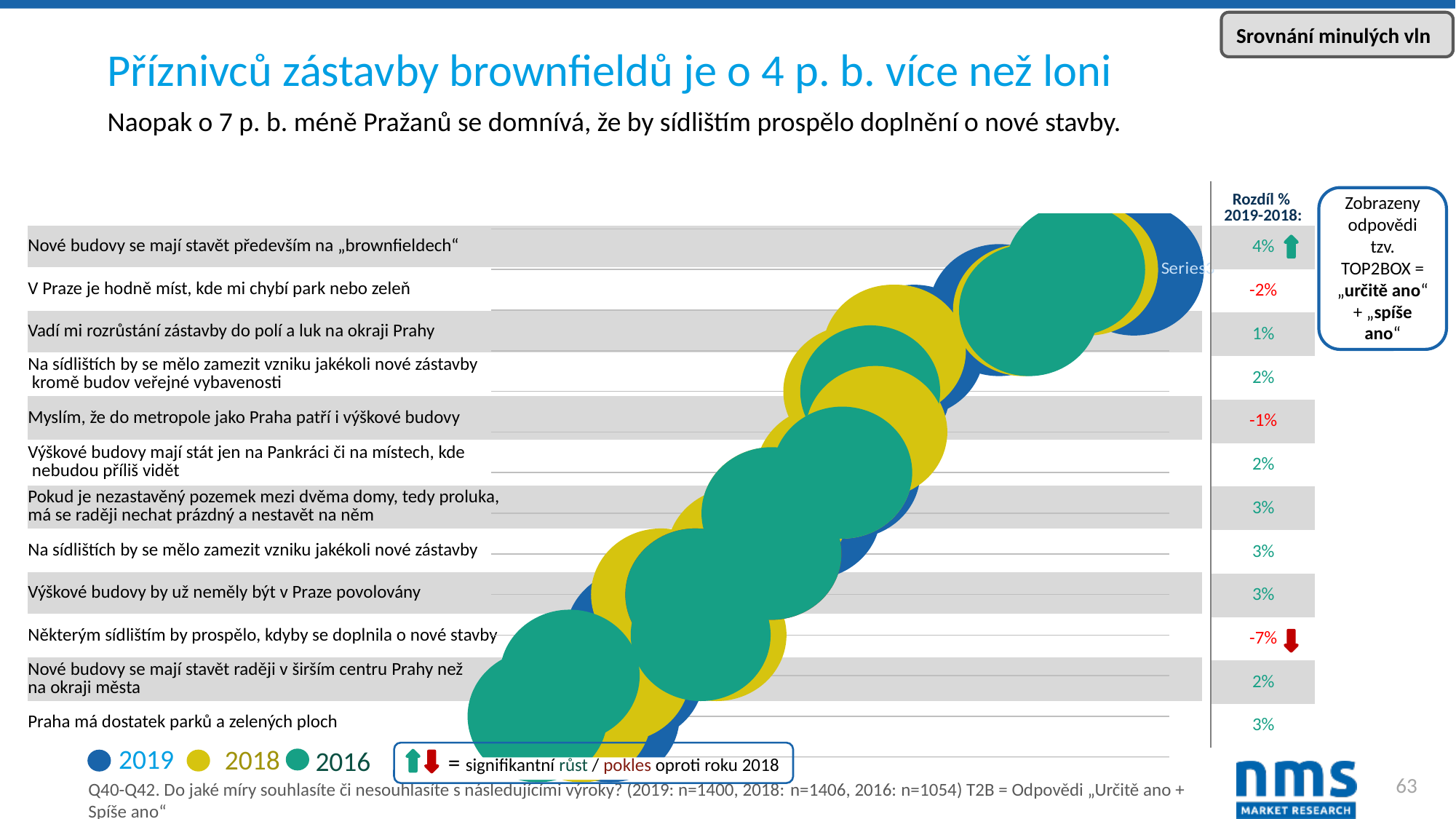
How many series does the legend list? 3 What is the 2019-2018 difference (Rozdíl %) shown for "Nové budovy se mají stavět především na „brownfieldech“"? 4% Which statement has the lowest (most negative) 2019-2018 difference in the Rozdíl % column? Některým sídlištím by prospělo, kdyby se doplnila o nové stavby Which statement has the largest positive 2019-2018 difference in the Rozdíl % column? Nové budovy se mají stavět především na „brownfieldech“ What is the 2019-2018 difference (Rozdíl %) shown for "Myslím, že do metropole jako Praha patří i výškové budovy"? -1% Going from the top statement to the bottom statement, do the plotted values rise or fall? Fall Which statement has the larger 2019 value: "Nové budovy se mají stavět především na „brownfieldech“" or "Praha má dostatek parků a zelených ploch"? Nové budovy se mají stavět především na „brownfieldech“ Which years are listed in the chart legend? 2019, 2018, 2016 How many statements (categories) are plotted in the chart? 12 What is the 2019-2018 difference (Rozdíl %) shown for "Některým sídlištím by prospělo, kdyby se doplnila o nové stavby"? -7% What colour represents the 2019 series in the legend? Blue What is the 2019-2018 difference (Rozdíl %) shown for "V Praze je hodně míst, kde mi chybí park nebo zeleň"? -2%